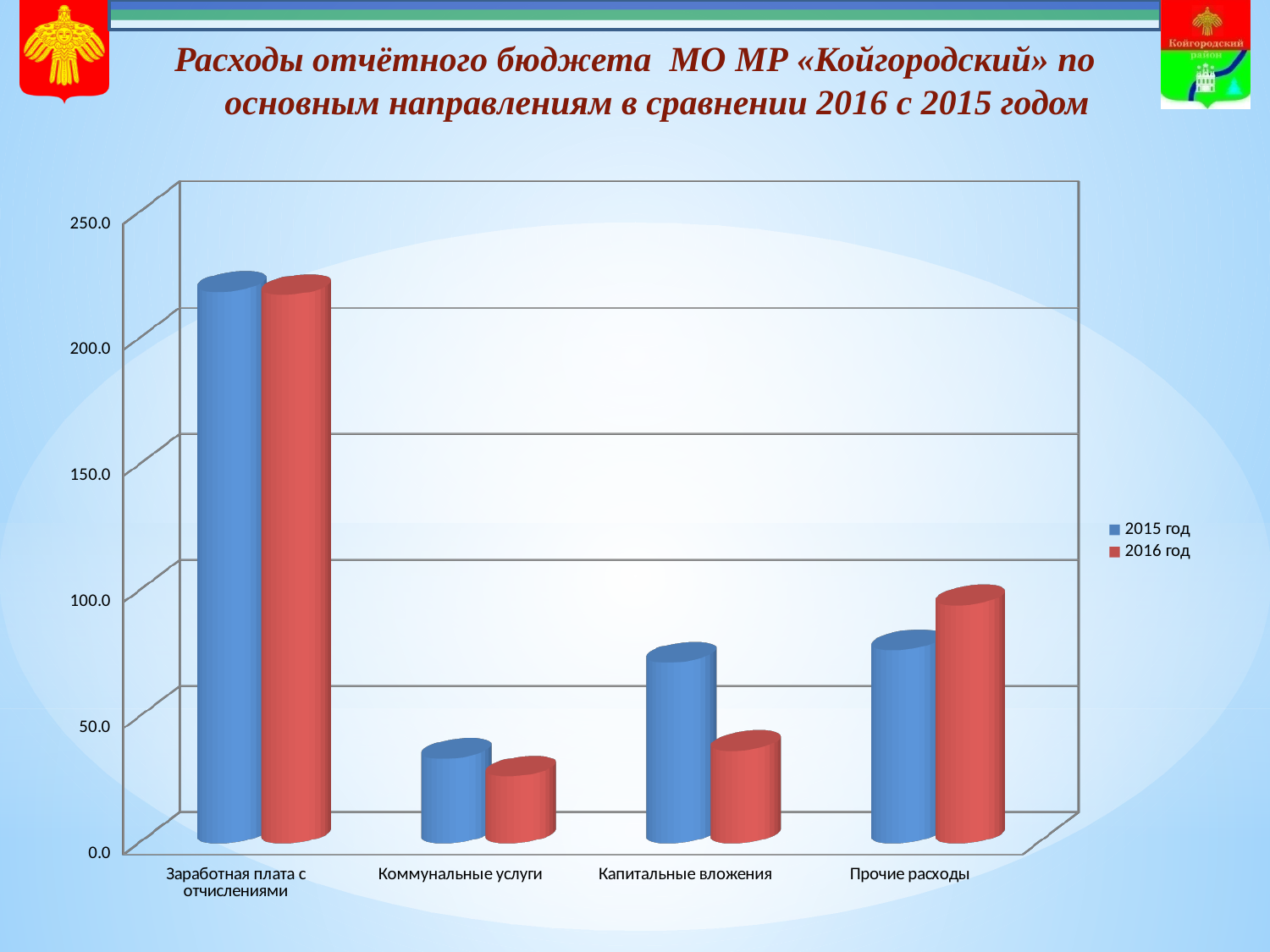
Is the value for Заработная плата с отчислениями in 2015 год greater or less than 200.0? greater Is the value for Коммунальные услуги in 2016 год greater or less than 50.0? less Is the value for Капитальные вложения in 2015 год greater or less than 50.0? greater For Прочие расходы, which series is larger: 2015 год or 2016 год? 2016 год How many categories are shown on the x axis of the chart? 4 How many series does the legend list? 2 Which colour represents the 2016 год series in the legend? red For Капитальные вложения, which series is larger: 2015 год or 2016 год? 2015 год What kind of chart is shown on the slide? bar chart Which category has the highest value for 2015 год? Заработная плата с отчислениями Which category has the lowest value for 2016 год? Коммунальные услуги